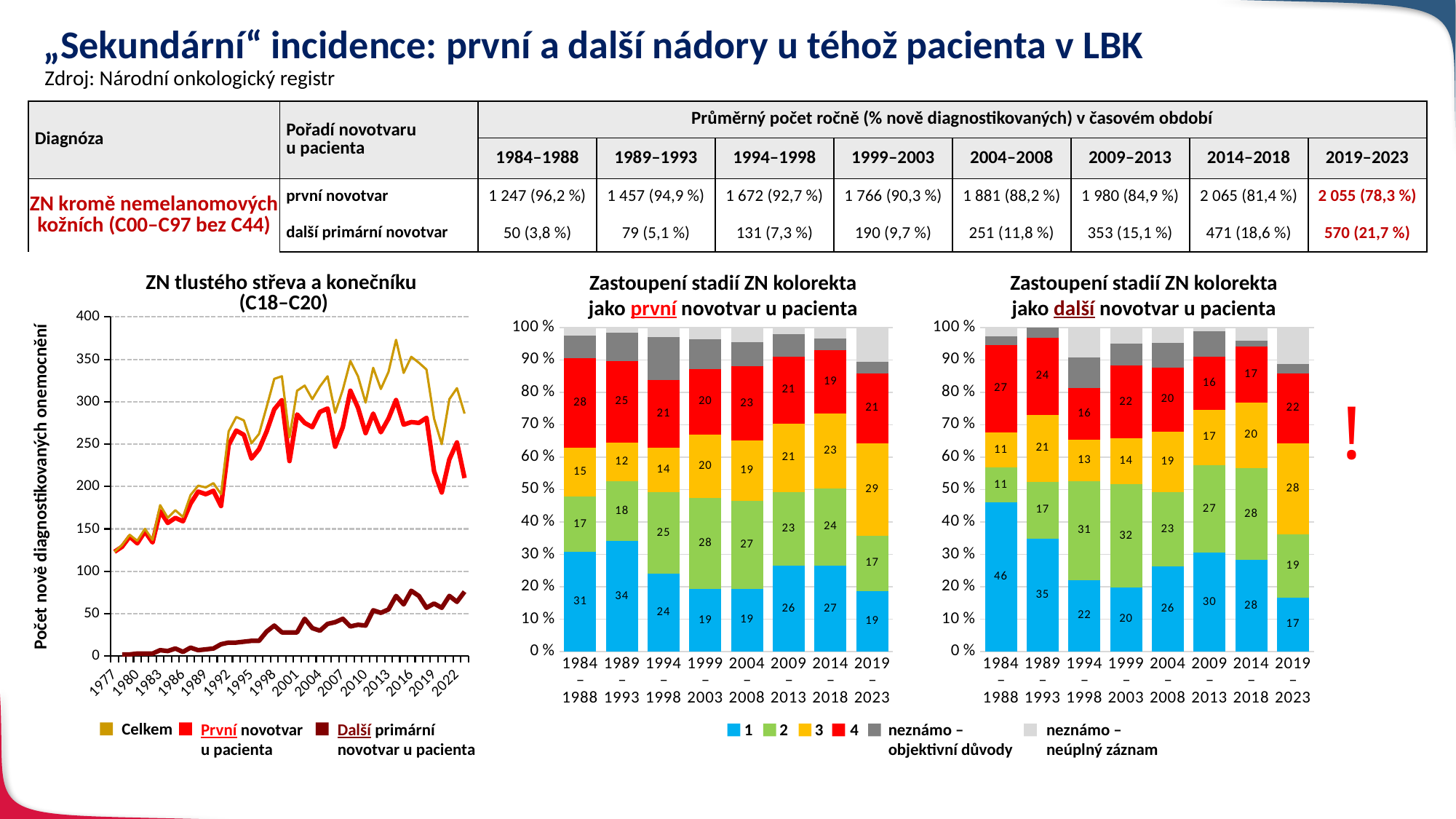
In the middle chart (první novotvar), what is the difference between the stage 3 value in 2019–2023 and in 1984–1988? 14 In the middle chart (první novotvar), what is the value for stage 4 in 2019–2023? 21 How many series does the legend of the left chart (ZN tlustého střeva a konečníku) list? 3 In the right chart (další novotvar), which period has the highest value for stage 1? 1984–1988 In the right chart (další novotvar), what is the value for stage 2 in 1999–2003? 32 In the right chart (Zastoupení stadií ZN kolorekta jako další novotvar u pacienta), what is the value for stage 1 in 1984–1988? 46 How many time periods are shown on the x axis of the middle chart (první novotvar)? 8 How many series does the legend of the stacked bar charts list? 6 In the left chart (ZN tlustého střeva a konečníku), is the value for Celkem in 1977 greater or less than 150? less In the middle chart (první novotvar), which period has the lowest value for stage 3? 1989–1993 What kind of chart is the left chart titled ZN tlustého střeva a konečníku (C18–C20)? line chart In the middle chart (Zastoupení stadií ZN kolorekta jako první novotvar u pacienta), what is the value for stage 1 in 1984–1988? 31